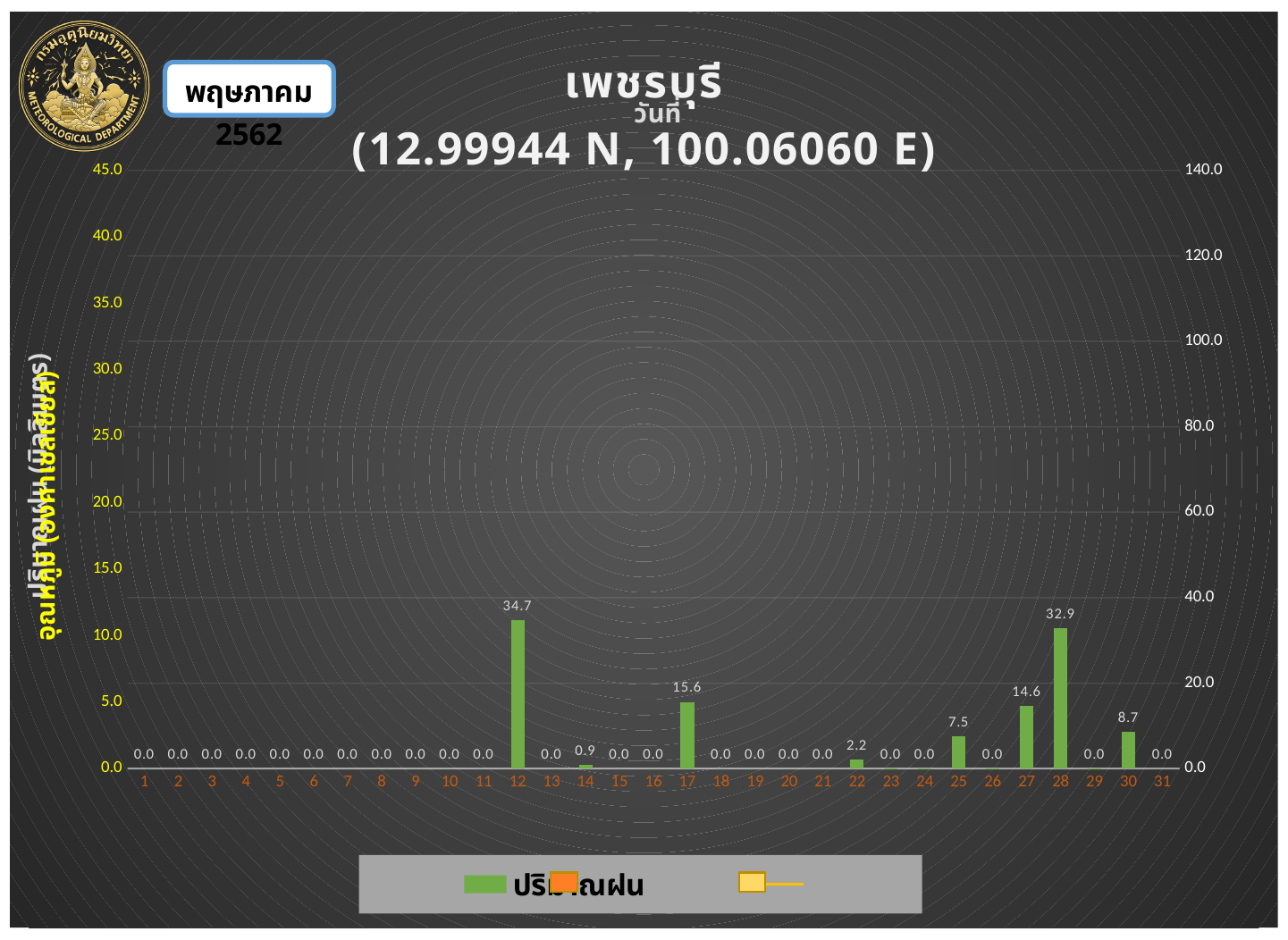
What kind of chart is shown on the slide? bar chart What is the difference between the rainfall values for day 17 and day 25? 8.1 What is the rainfall value shown for day 22? 2.2 What is the rainfall value shown for day 12? 34.7 What coordinates are given in the chart title? 12.99944 N, 100.06060 E What is the rainfall value shown for day 17? 15.6 What is the difference between the rainfall values for day 12 and day 28? 1.8 What is the rainfall value shown for day 28? 32.9 What is the rainfall value shown for day 14? 0.9 How many days are shown on the x axis? 31 Which is larger, the rainfall value for day 27 or for day 30? day 27 Which day has the highest rainfall value? 12